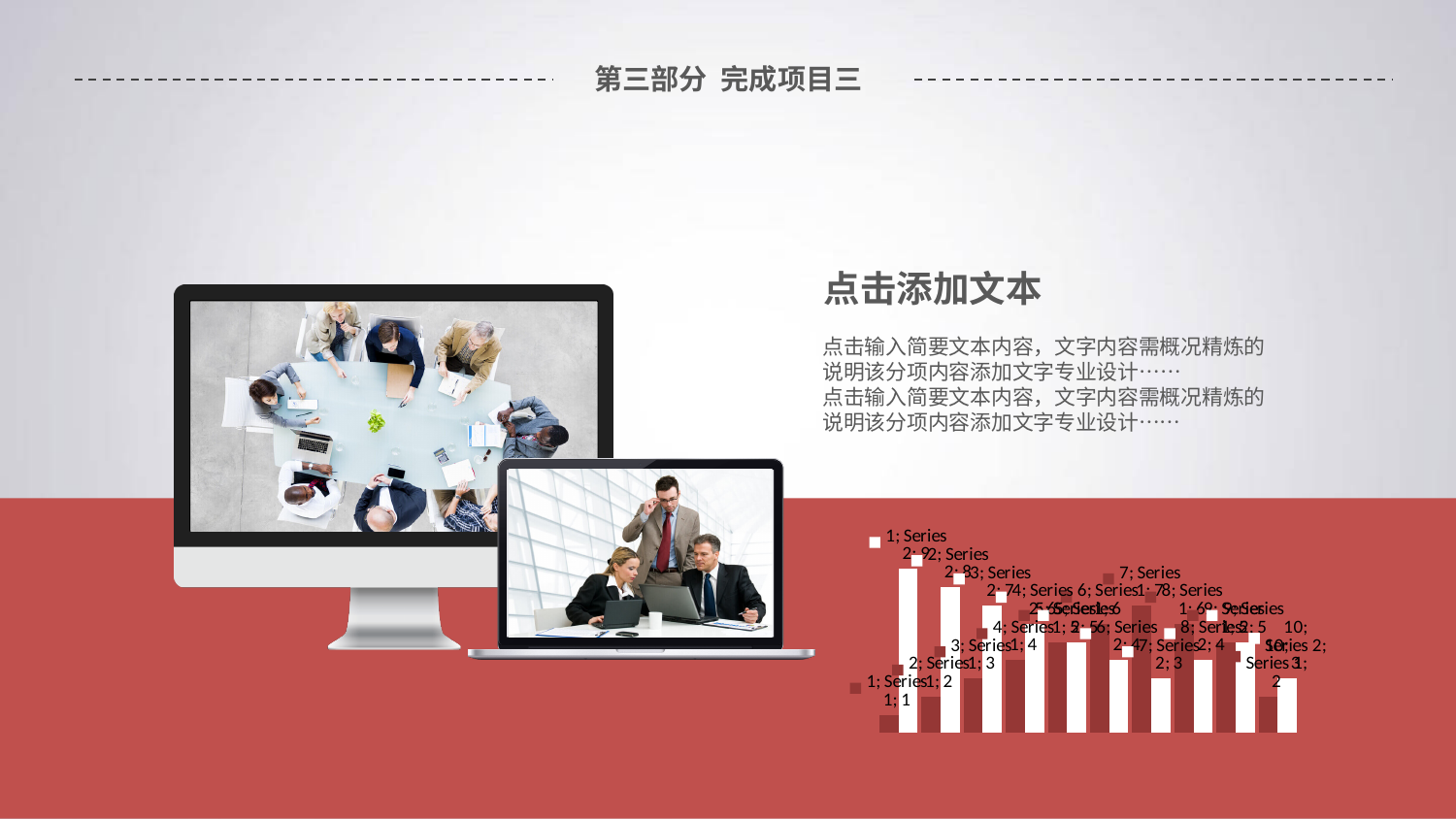
What colour are the Series 1 bars in the chart? red What kind of chart is shown on the slide? bar chart What is the value for category 1 in Series 1? 1 What is the value for category 3 in Series 1? 3 What is the value for category 4 in Series 1? 4 What is the value for category 2 in Series 1? 2 What is the difference between the Series 1 values for category 4 and category 1? 3 How many data series are named in the chart's data labels? 2 Which is larger in Series 1: the value for category 1 or the value for category 4? category 4 Do the Series 1 values rise or fall from category 1 to category 4? rise